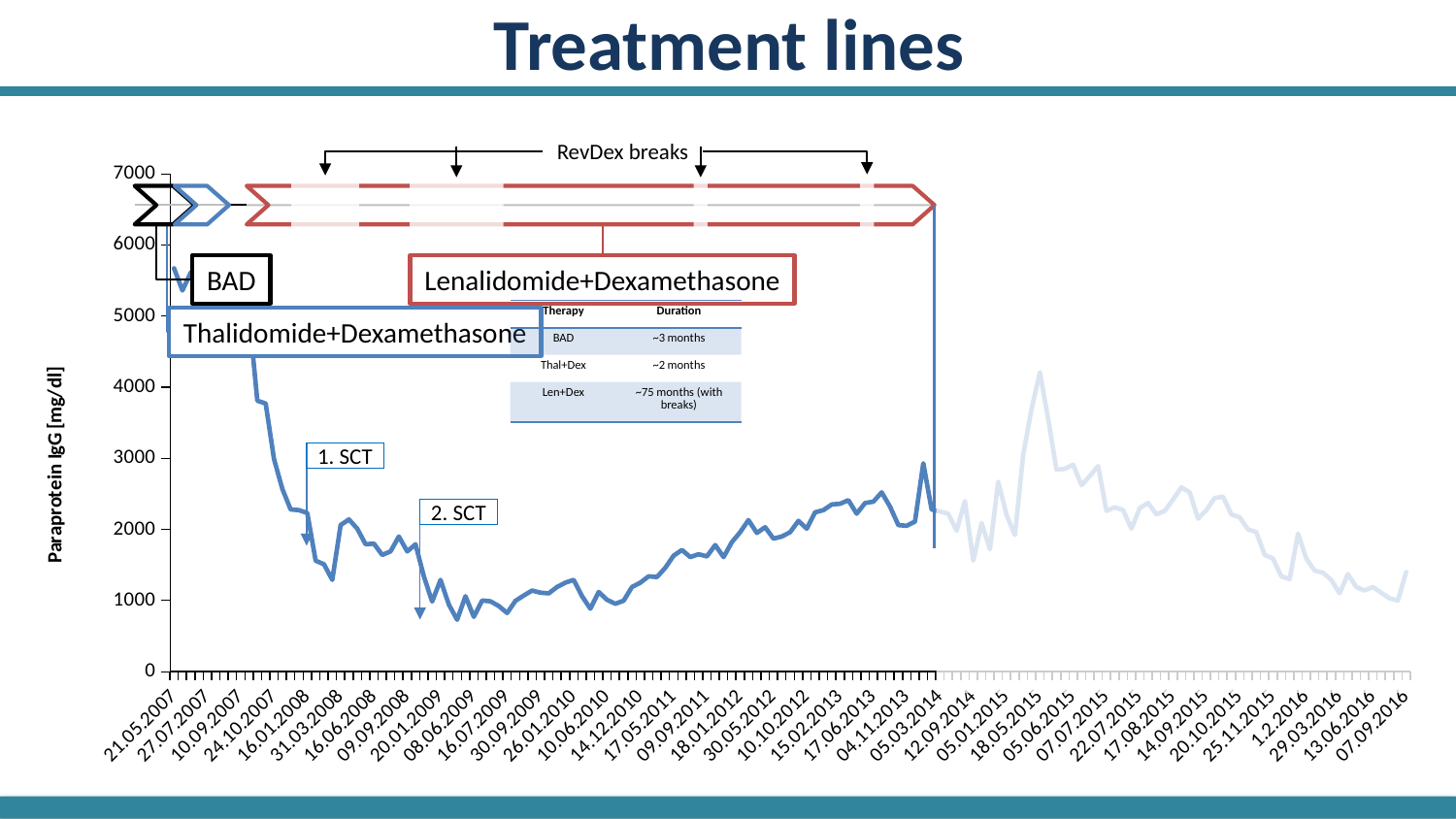
Is the value for 07.09.2016 greater or less than 2000? less According to the table on the chart, what is the duration of Len+Dex therapy? ~75 months (with breaks) Do the values rise or fall between 18.05.2015 and 07.09.2016? fall Is the lowest value of the line greater or less than 1000? less Do the values rise or fall between 21.05.2007 and 20.01.2009? fall What is the label of the y axis of the chart? Paraprotein IgG [mg/dl] Which is larger, the value for 21.05.2007 or the value for 07.09.2016? 21.05.2007 What kind of chart is shown on the slide? line chart Do the values rise or fall between 10.06.2010 and 17.06.2013? rise Is the value for 17.06.2013 greater or less than 2000? greater